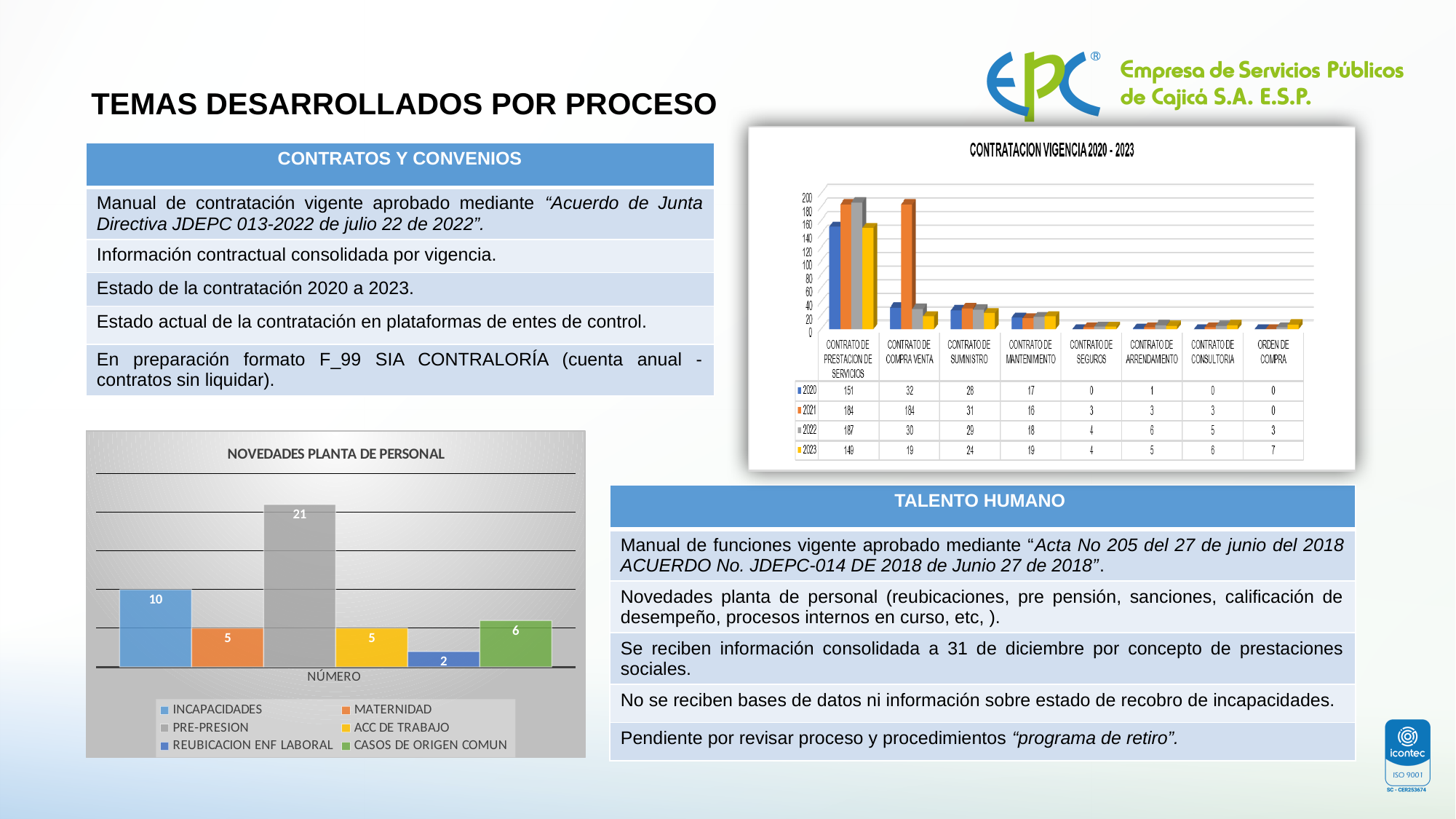
In the 'NOVEDADES PLANTA DE PERSONAL' chart, what is the value for PRE-PRESION? 21 In the 'NOVEDADES PLANTA DE PERSONAL' chart, how many series does the legend list? 6 In the 'CONTRATACION VIGENCIA 2020 - 2023' chart, what is the value for CONTRATO DE PRESTACION DE SERVICIOS in 2022? 187 What kind of chart is 'NOVEDADES PLANTA DE PERSONAL'? bar chart In the 'CONTRATACION VIGENCIA 2020 - 2023' chart, how many series does the legend list? 4 In the 'NOVEDADES PLANTA DE PERSONAL' chart, which series has the lowest value? REUBICACION ENF LABORAL In the 'CONTRATACION VIGENCIA 2020 - 2023' chart, is the 2020 value for CONTRATO DE SUMINISTRO larger or smaller than the 2021 value? smaller In the 'CONTRATACION VIGENCIA 2020 - 2023' chart, which category has the highest value for 2023? CONTRATO DE PRESTACION DE SERVICIOS In the 'CONTRATACION VIGENCIA 2020 - 2023' chart, how many contract categories are shown on the x axis? 8 In the 'CONTRATACION VIGENCIA 2020 - 2023' chart, what is the difference between the 2021 and 2023 values for CONTRATO DE COMPRA VENTA? 165 In the 'CONTRATACION VIGENCIA 2020 - 2023' chart, what is the value for CONTRATO DE COMPRA VENTA in 2021? 184 In the 'NOVEDADES PLANTA DE PERSONAL' chart, what is the difference between INCAPACIDADES and CASOS DE ORIGEN COMUN? 4